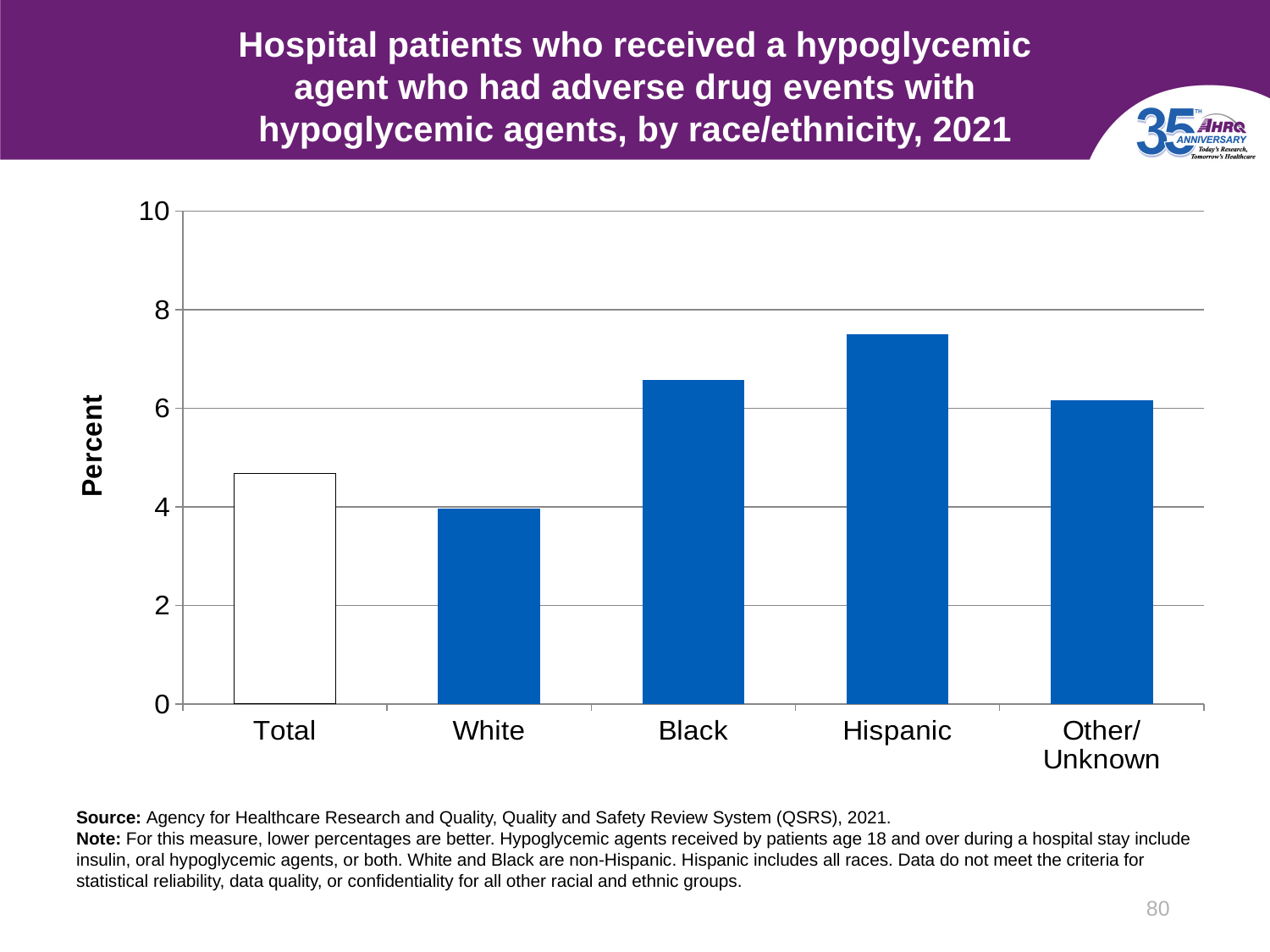
What is the label on the vertical axis? Percent Is the value for Black greater or less than 6? greater Is the value for Other/Unknown greater or less than 8? less Is the value for Total greater or less than 6? less Which category has the lowest percentage? White Which category has the highest percentage? Hispanic Which is larger, the value for Black or the value for White? Black How many race/ethnicity categories are plotted on the chart? 5 Which is larger, the value for Total or the value for Hispanic? Hispanic What kind of chart is shown on the slide? bar chart